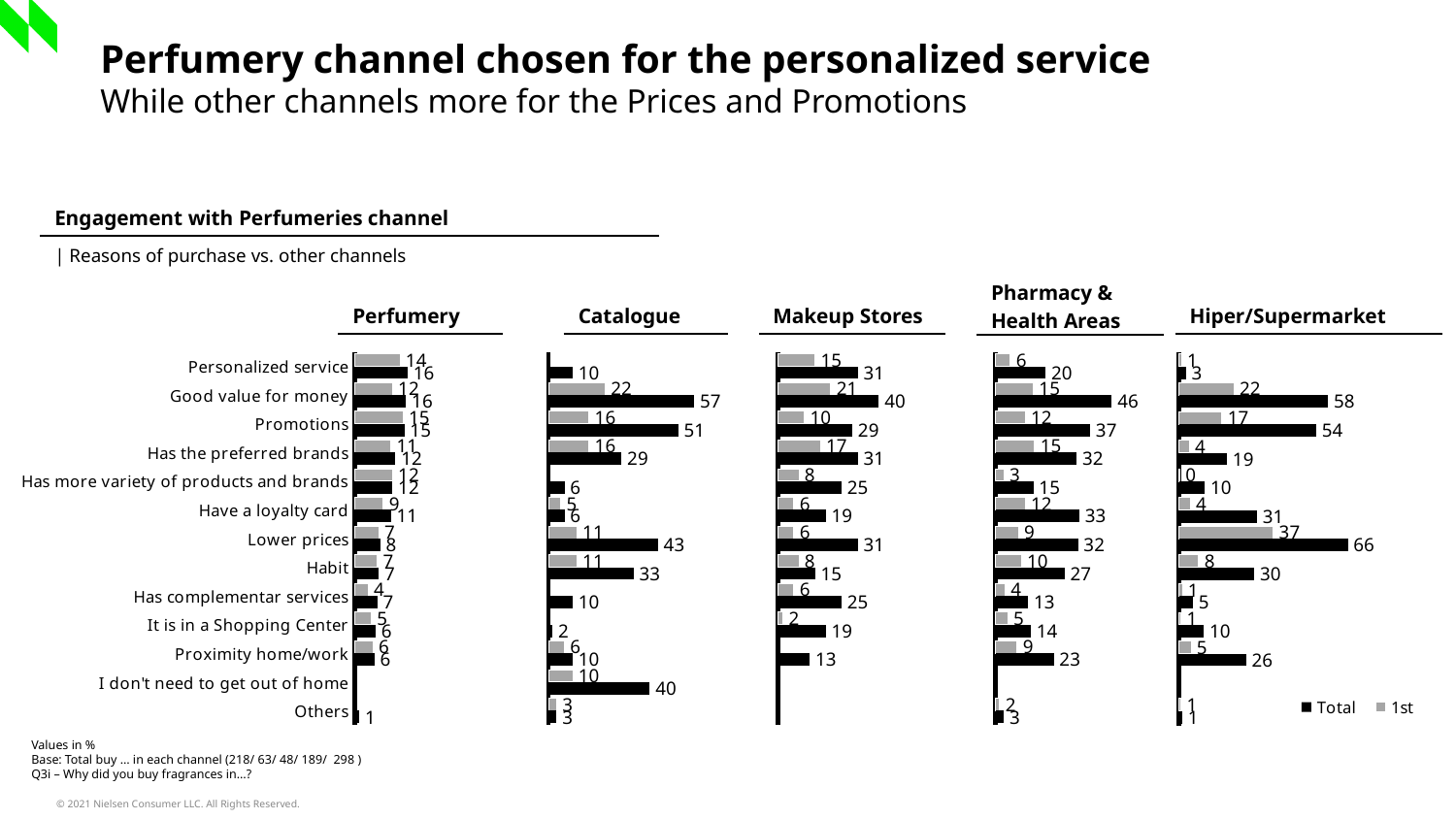
In the Hiper/Supermarket chart, what is the Total value for Lower prices? 66 In the Perfumery chart, what is the Total value for Personalized service? 16 In the Pharmacy & Health Areas chart, what is the 1st value for Promotions? 12 In the Hiper/Supermarket chart, what is the difference between the Total and 1st values for Lower prices? 29 In the Hiper/Supermarket chart, which reason has the highest Total value? Lower prices In the Pharmacy & Health Areas chart, what is the difference between the Total values for Good value for money and Promotions? 9 In the Catalogue chart, which reason has the highest Total value? Good value for money What kind of chart is used for the Perfumery data? Bar chart In the Makeup Stores chart, which is larger: the Total value for Personalized service or the Total value for Habit? Personalized service In the Makeup Stores chart, what is the Total value for Good value for money? 40 In the Catalogue chart, what is the Total value for Good value for money? 57 How many series does the legend list? 2